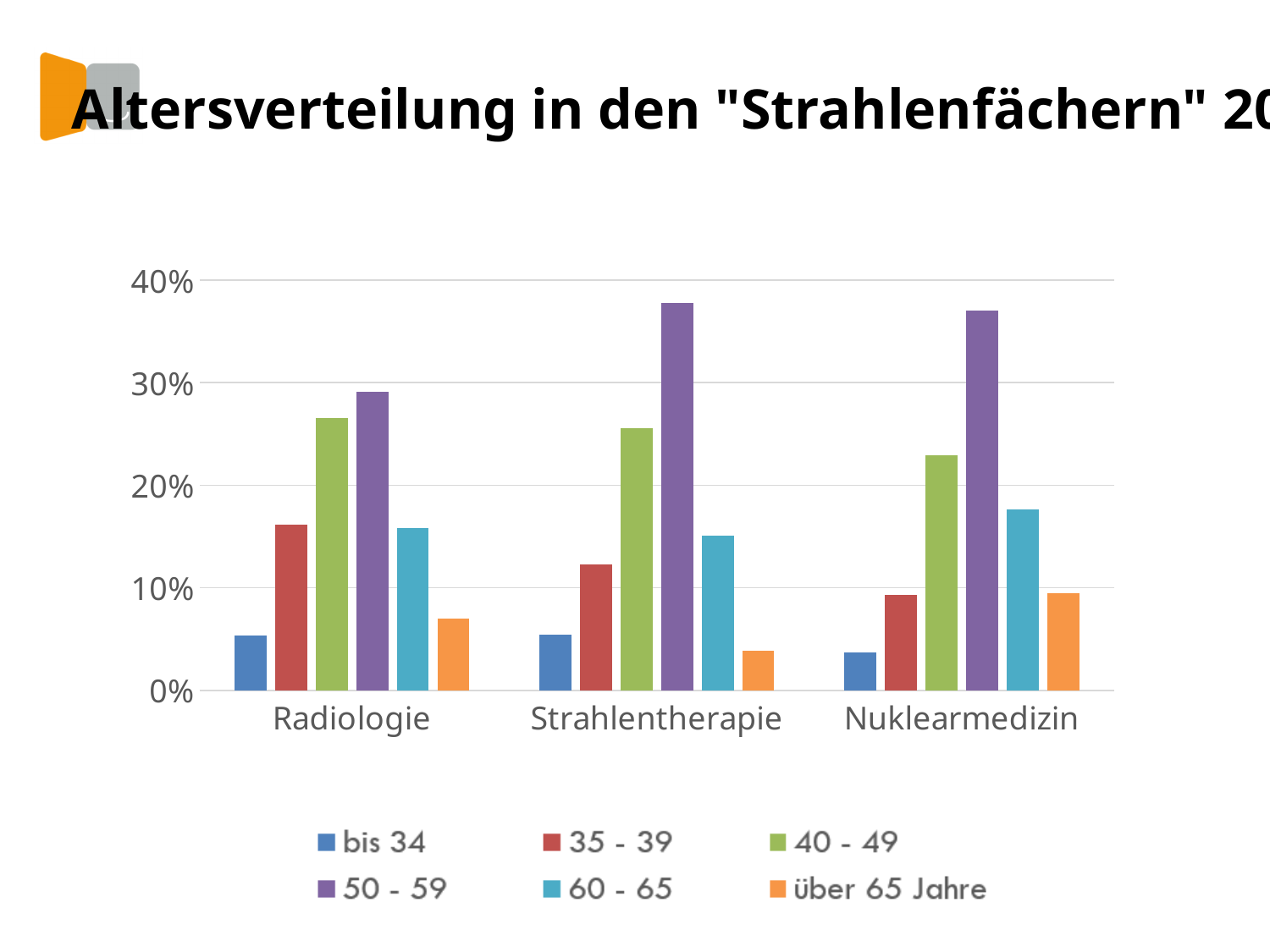
Is the value for the über 65 Jahre age group in Strahlentherapie greater or less than 10%? less Is the value for the 50 - 59 age group in Strahlentherapie greater or less than 30%? greater How many age groups does the legend list? 6 How many specialties (categories) are shown on the x axis? 3 Is the value for the bis 34 age group in Nuklearmedizin greater or less than 10%? less Which age group has the highest share in Strahlentherapie? 50 - 59 What colour represents the 50 - 59 age group in the chart? purple Which age group has the lowest share in Nuklearmedizin? bis 34 Which specialty has the larger share of the 50 - 59 age group, Radiologie or Strahlentherapie? Strahlentherapie What kind of chart is shown on the slide? bar chart Which age group has the highest share in Radiologie? 50 - 59